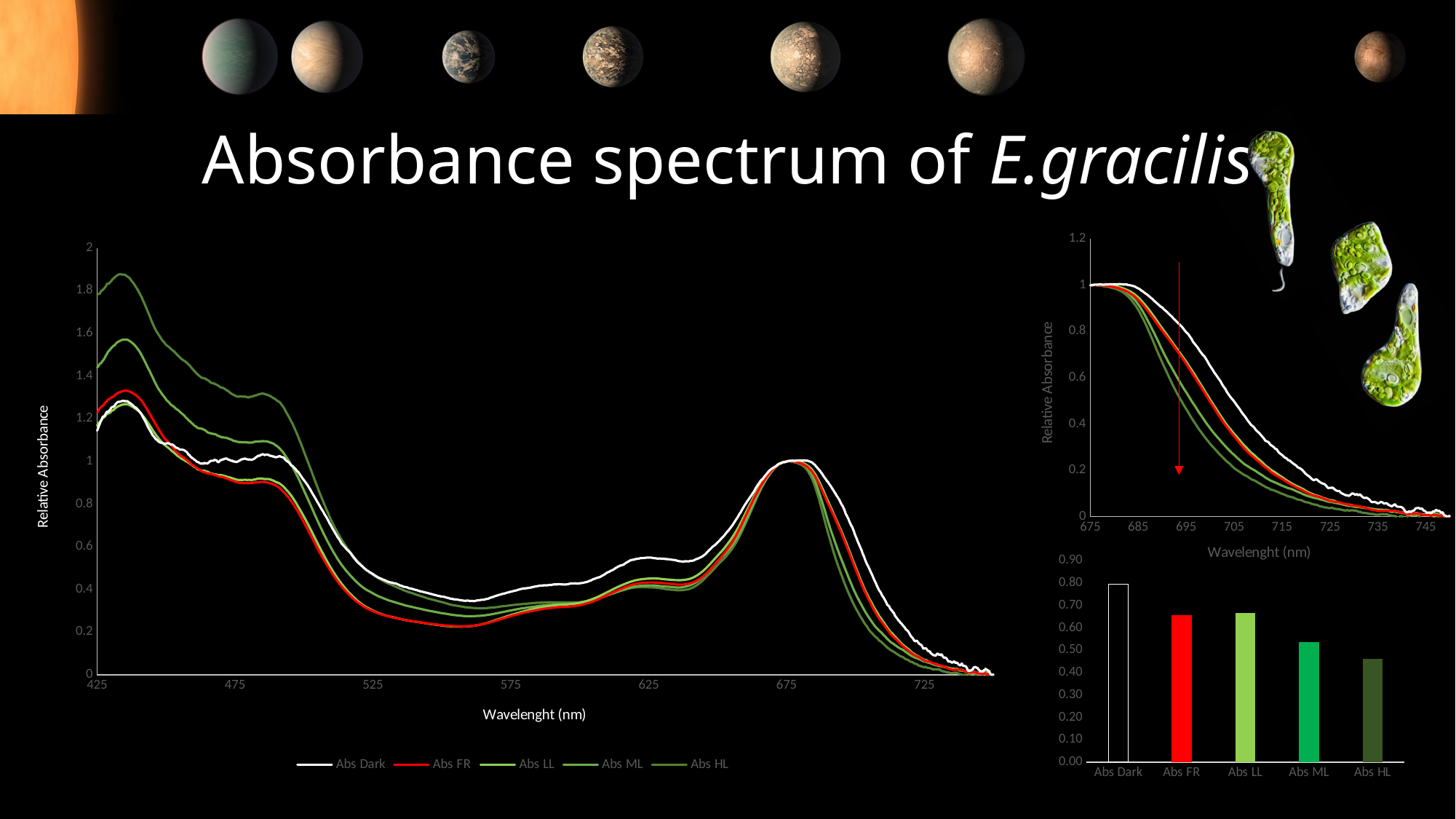
In the bar chart in the bottom right, is the value for Abs HL greater or less than 0.50? less In the bar chart in the bottom right, which category has the highest value? Abs Dark What kind of chart is the chart in the bottom right of the slide? bar chart What kind of chart is the large chart on the left of the slide? line chart What is the x-axis label of the large line chart on the left? Wavelenght (nm) In the bar chart in the bottom right, is the value for Abs Dark greater or less than 0.70? greater How many categories are shown in the bar chart in the bottom right? 5 In the bar chart in the bottom right, is the value for Abs ML greater or less than 0.60? less In the bar chart in the bottom right, which is larger, the value for Abs Dark or the value for Abs ML? Abs Dark In the small line chart in the top right, do the values rise or fall as wavelength increases from 675 to 745 nm? fall How many series does the legend of the large line chart on the left list? 5 In the bar chart in the bottom right, which category has the lowest value? Abs HL